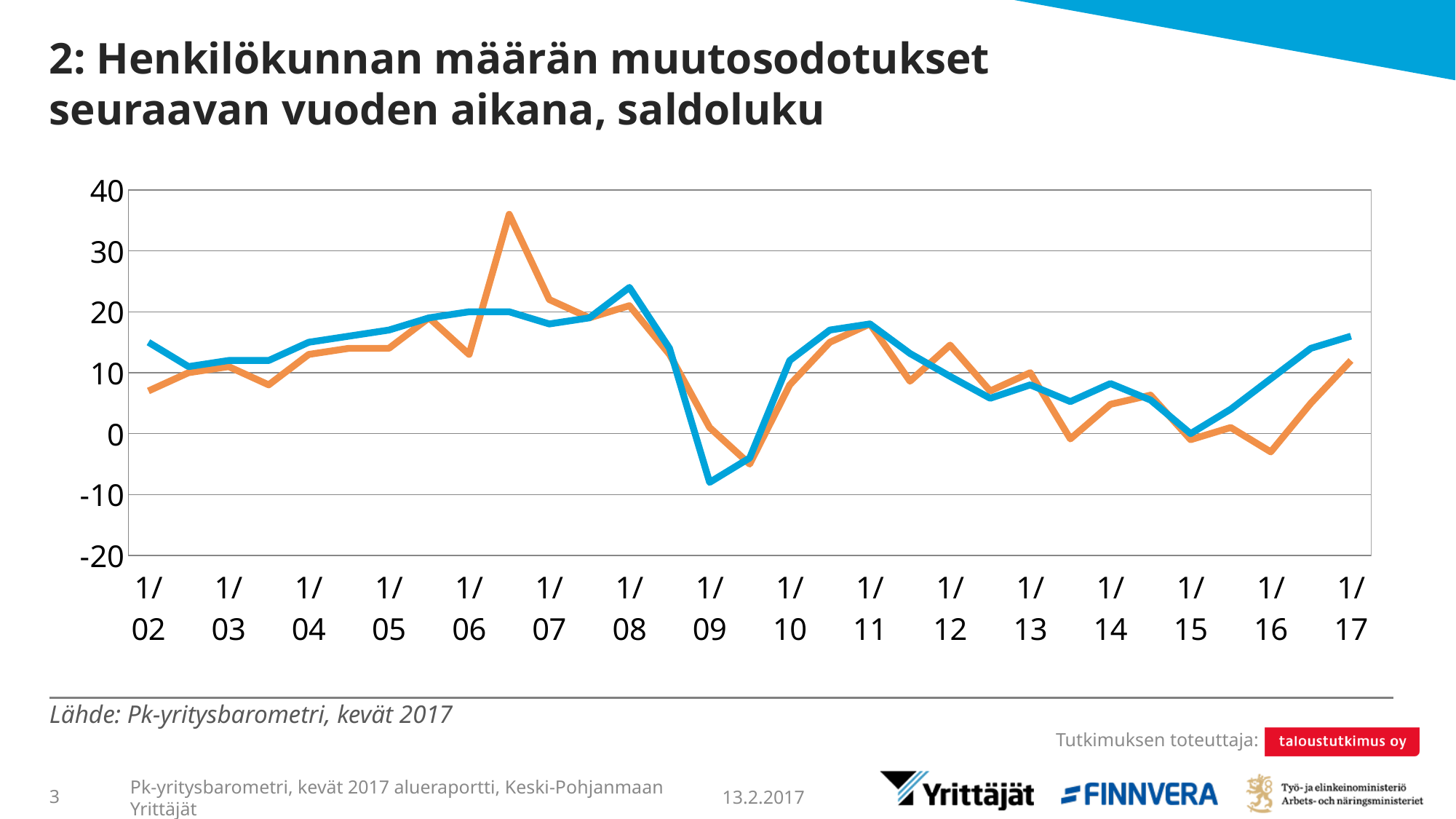
Is the value of the blue line at 1/17 greater or less than 10? greater How many time points are labelled on the x axis of the chart? 16 Which line reaches the higher peak overall, the blue line or the orange line? orange line Is the value of the blue line at 1/09 greater or less than 0? less What kind of chart is shown on the slide? line chart Is the value of the orange line at 1/16 greater or less than 0? less Does the blue line rise or fall between 1/15 and 1/17? rise How many lines are plotted in the chart? 2 At which x-axis label does the blue line reach its lowest value? 1/09 What is the highest value shown on the y axis? 40